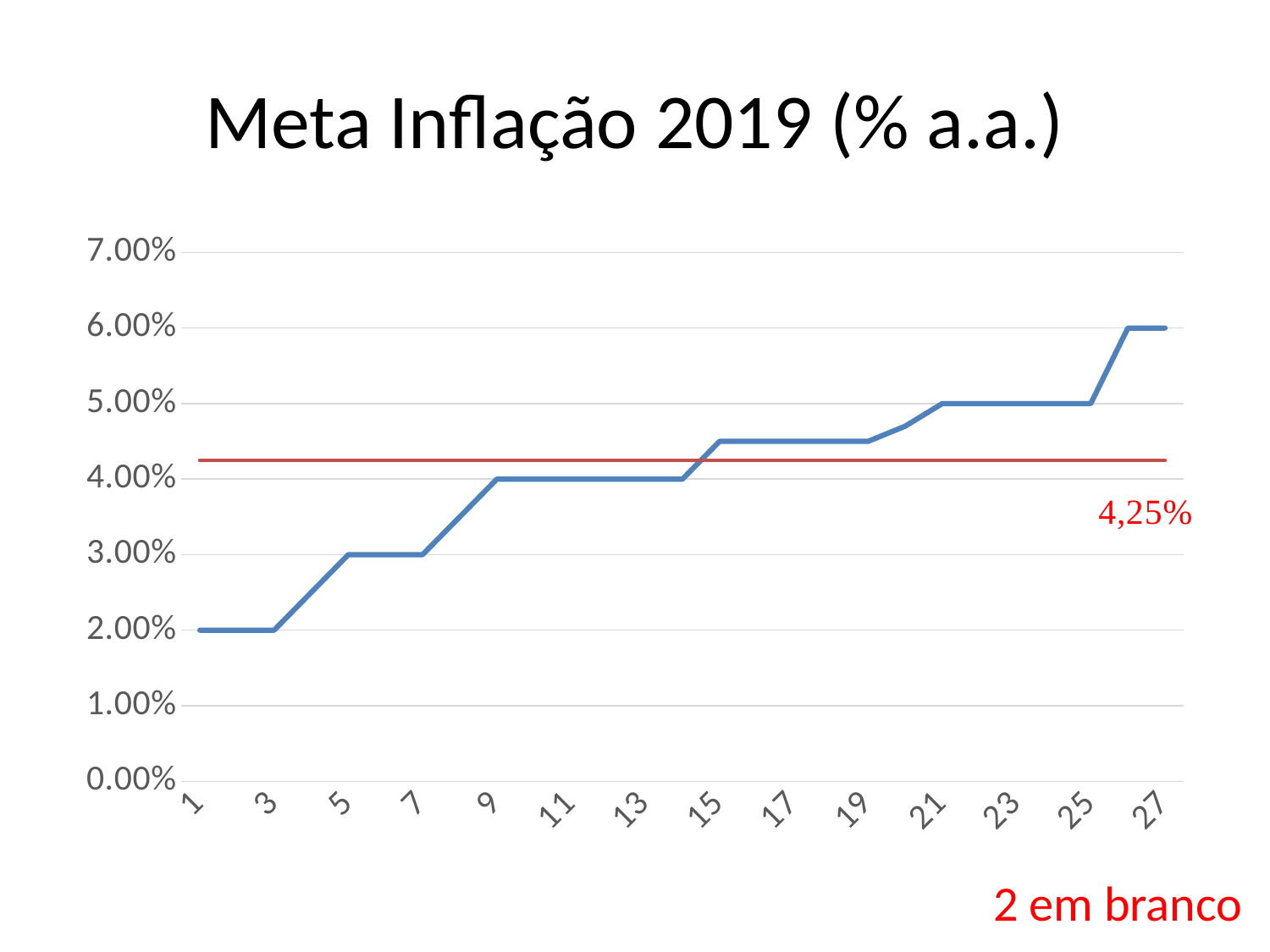
What is the title of the chart? Meta Inflação 2019 (% a.a.) What is the highest value reached by the blue line? 6.00% What is the value of the blue line at point 21? 5.00% What is the value of the blue line at point 9? 4.00% Is the value of the blue line at point 17 greater or less than 4.00%? greater What is the value of the blue line at point 5? 3.00% What kind of chart is shown on the slide? line chart What is the lowest value of the blue line? 2.00% What is the value of the blue line at point 27? 6.00% Do the values of the blue line rise or fall from left to right along the x axis? rise What is the value of the blue line at point 1? 2.00% What is the difference between the value at point 27 and the value at point 1? 4.00%